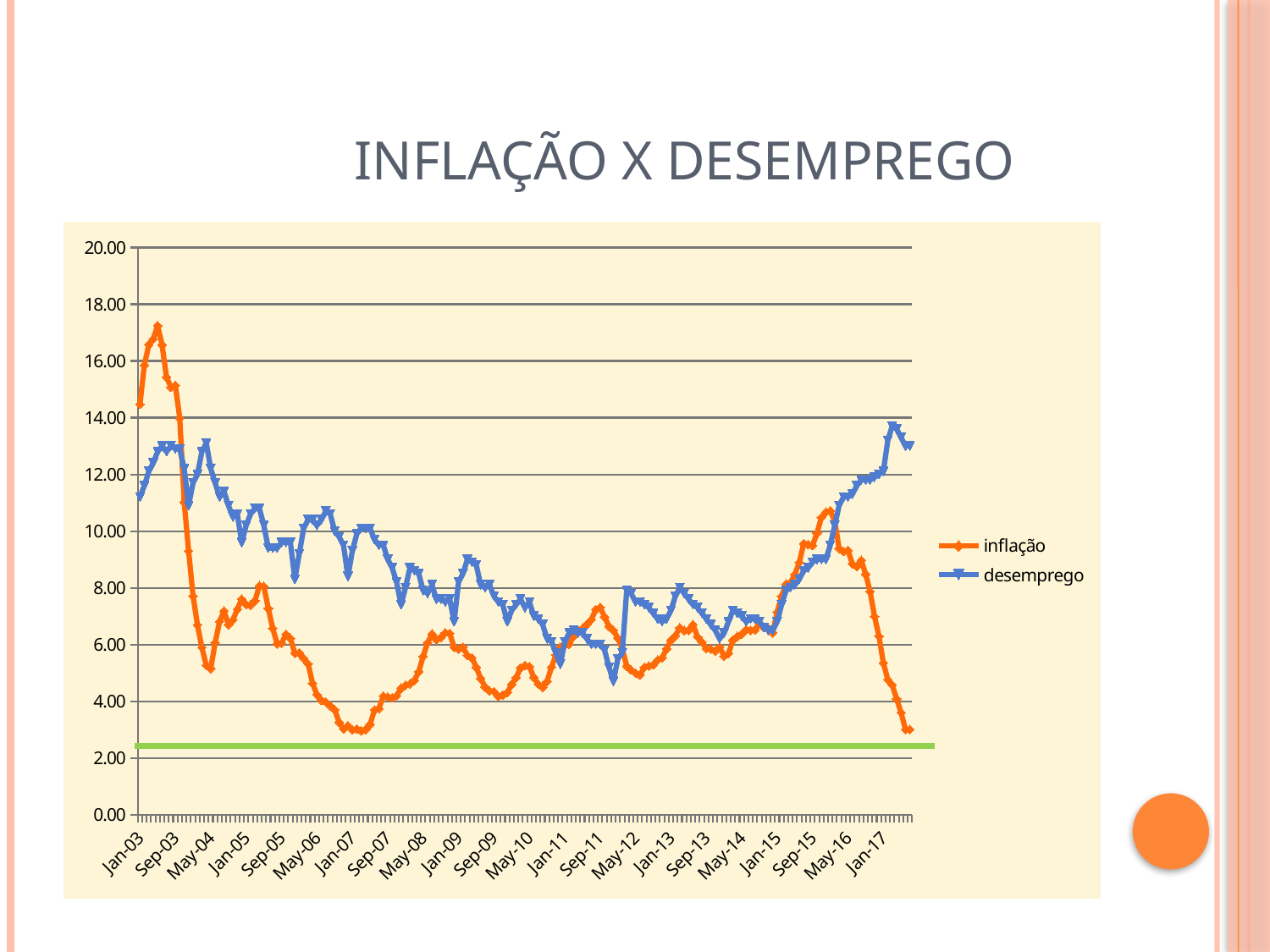
What kind of chart is shown on the slide? line chart Is the value of desemprego at Jan-03 greater or less than 10.00? greater At Jan-03, which series has the higher value, inflação or desemprego? inflação What is the title of the slide? INFLAÇÃO X DESEMPREGO How many series does the legend list? 2 Is the value of desemprego at the last point (after Jan-17) greater or less than 12.00? greater What are the two series named in the legend? inflação and desemprego At Jan-17, which series has the higher value, inflação or desemprego? desemprego Which series reaches the highest value anywhere on the chart? inflação Is the peak value of the inflação series greater or less than 16.00? greater Does the desemprego series rise or fall between Jan-15 and Jan-17? rise